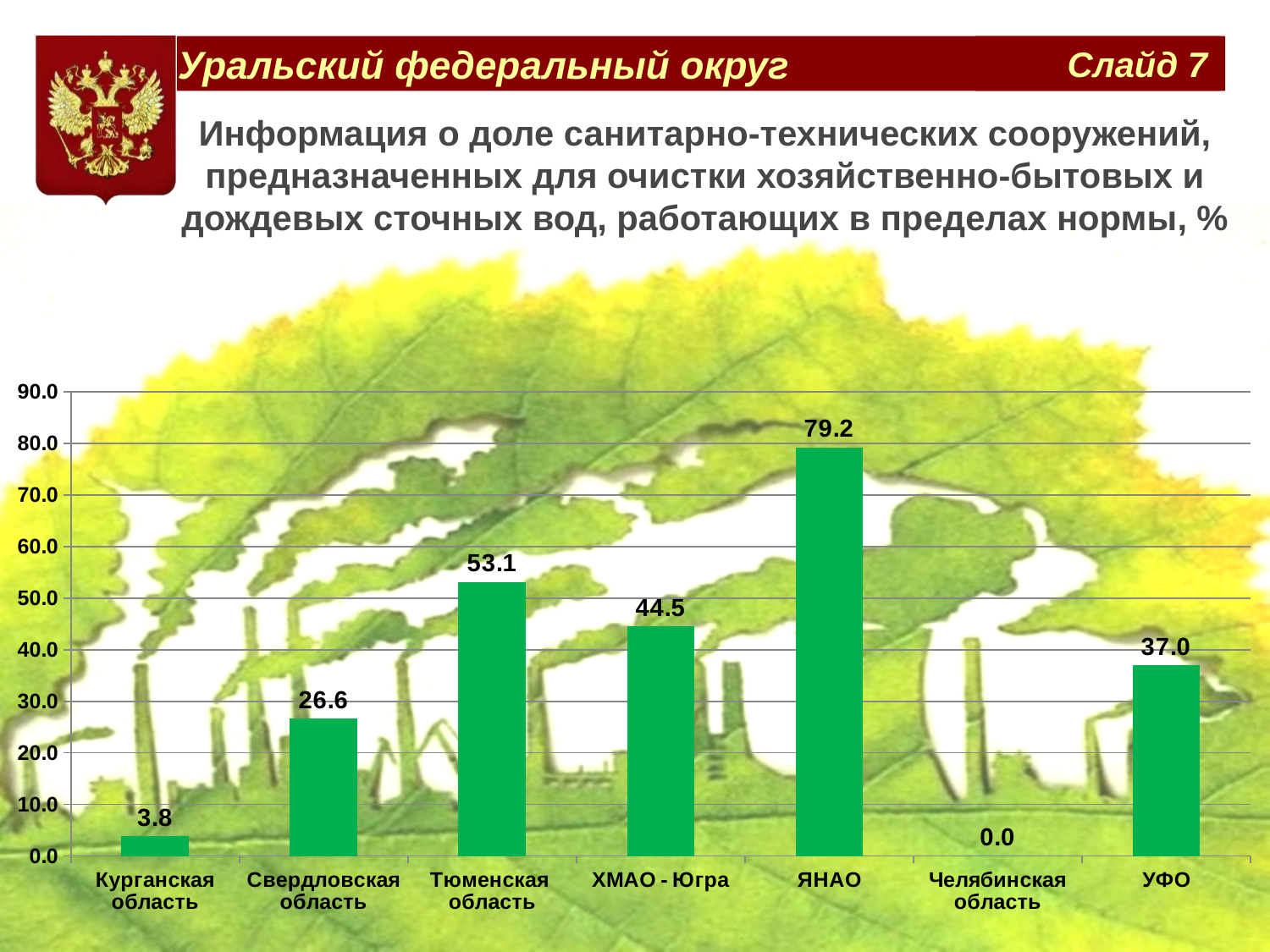
What is the value for УФО? 37.0 Is the value for Свердловская область greater or less than 30.0? less What is the difference between the values for ХМАО - Югра and Свердловская область? 17.9 What is the value for Курганская область? 3.8 Which is larger, the value for Тюменская область or the value for ХМАО - Югра? Тюменская область Which category has the lowest value? Челябинская область What kind of chart is shown on the slide? bar chart What is the difference between the values for ЯНАО and Тюменская область? 26.1 How many categories are shown on the x axis? 7 What is the value for Челябинская область? 0.0 Which category has the highest value? ЯНАО What is the value for ЯНАО? 79.2